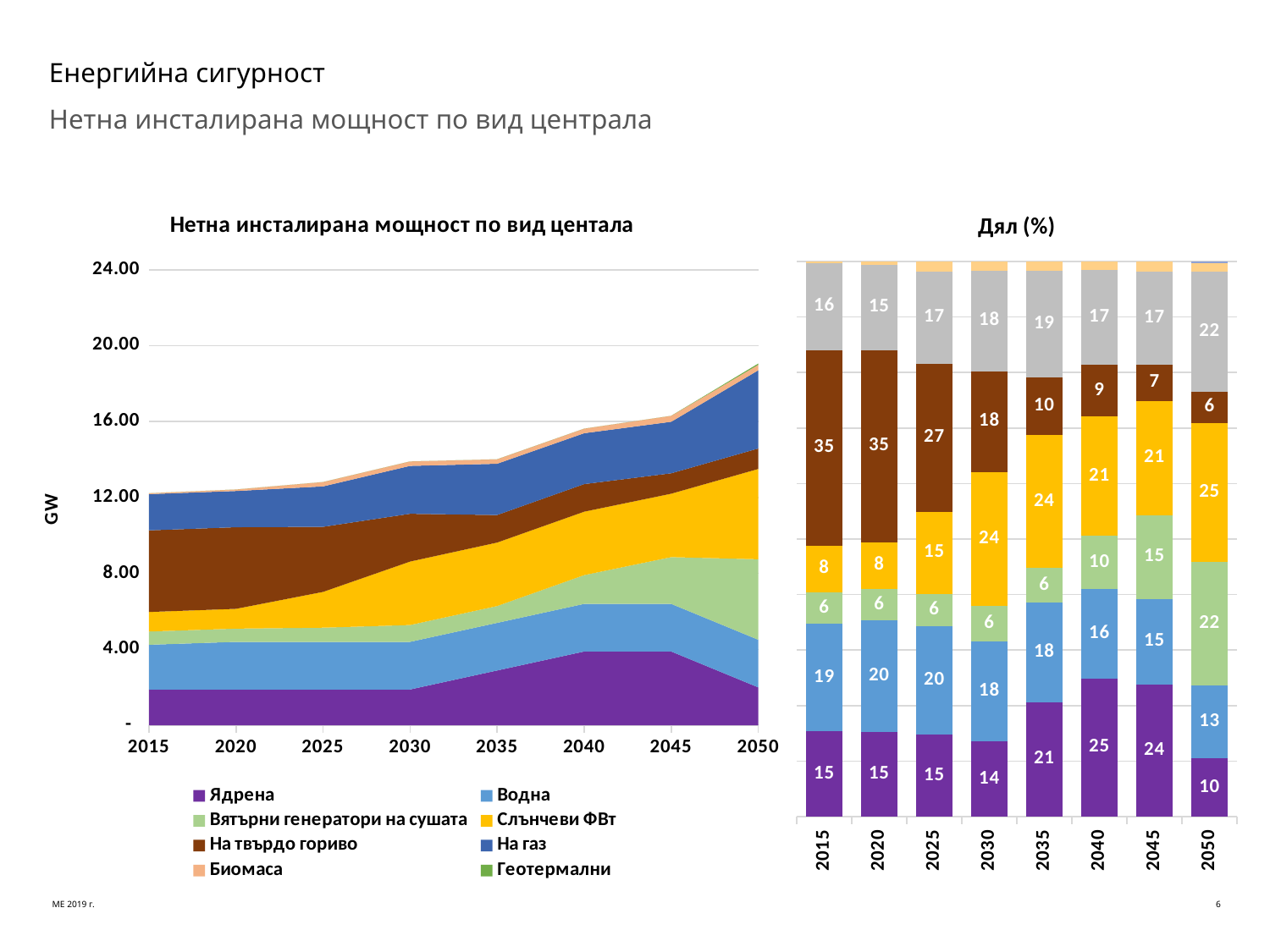
What kind of chart is the left chart titled 'Нетна инсталирана мощност по вид централа'? area chart In the 'Дял (%)' chart, what is the share of На твърдо гориво in 2015? 35 In the left chart, is the total net installed capacity in 2050 greater or less than 16.00 GW? greater In the 'Дял (%)' chart, in which year is the share of Слънчеви ФВт highest? 2050 How many years are shown on the x axis of the left chart? 8 How many series does the legend of the left chart list? 8 In the 'Дял (%)' chart, is the share of Водна larger in 2020 or in 2050? 2020 In the 'Дял (%)' chart, what is the difference between the share of На твърдо гориво in 2015 and in 2050? 29 In the 'Дял (%)' chart, what is the share of На газ in 2035? 19 In the 'Дял (%)' chart, in which year is the share of На твърдо гориво lowest? 2050 In the 'Дял (%)' chart, what is the share of Ядрена in 2050? 10 What kind of chart is the right chart titled 'Дял (%)'? bar chart